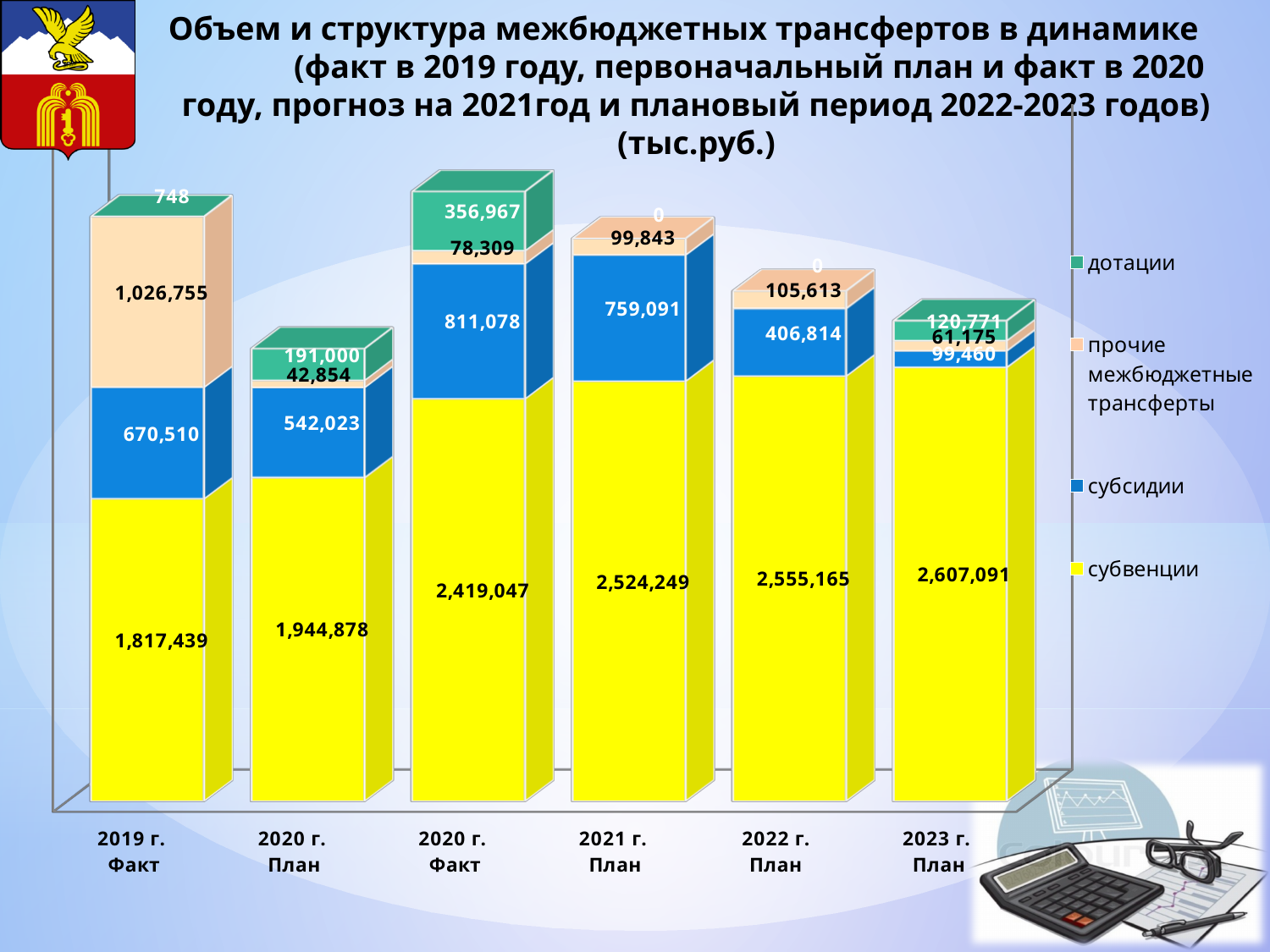
Which is larger: прочие межбюджетные трансферты for 2019 г. Факт or for 2020 г. Факт? 2019 г. Факт Which category has the highest value of субвенции? 2023 г. План What is the difference between субсидии for 2020 г. Факт and 2021 г. План? 51,987 What is the value of субсидии for 2019 г. Факт? 670,510 What is the value of дотации for 2020 г. План? 191,000 Which category has the lowest value of субсидии? 2023 г. План How many categories are shown on the x axis? 6 What is the total of the stacked bar for 2021 г. План? 3,383,183 What kind of chart is shown on the slide? Stacked bar chart How many series does the legend list? 4 What is the value of прочие межбюджетные трансферты for 2022 г. План? 105,613 What is the value of субвенции for 2020 г. Факт? 2,419,047